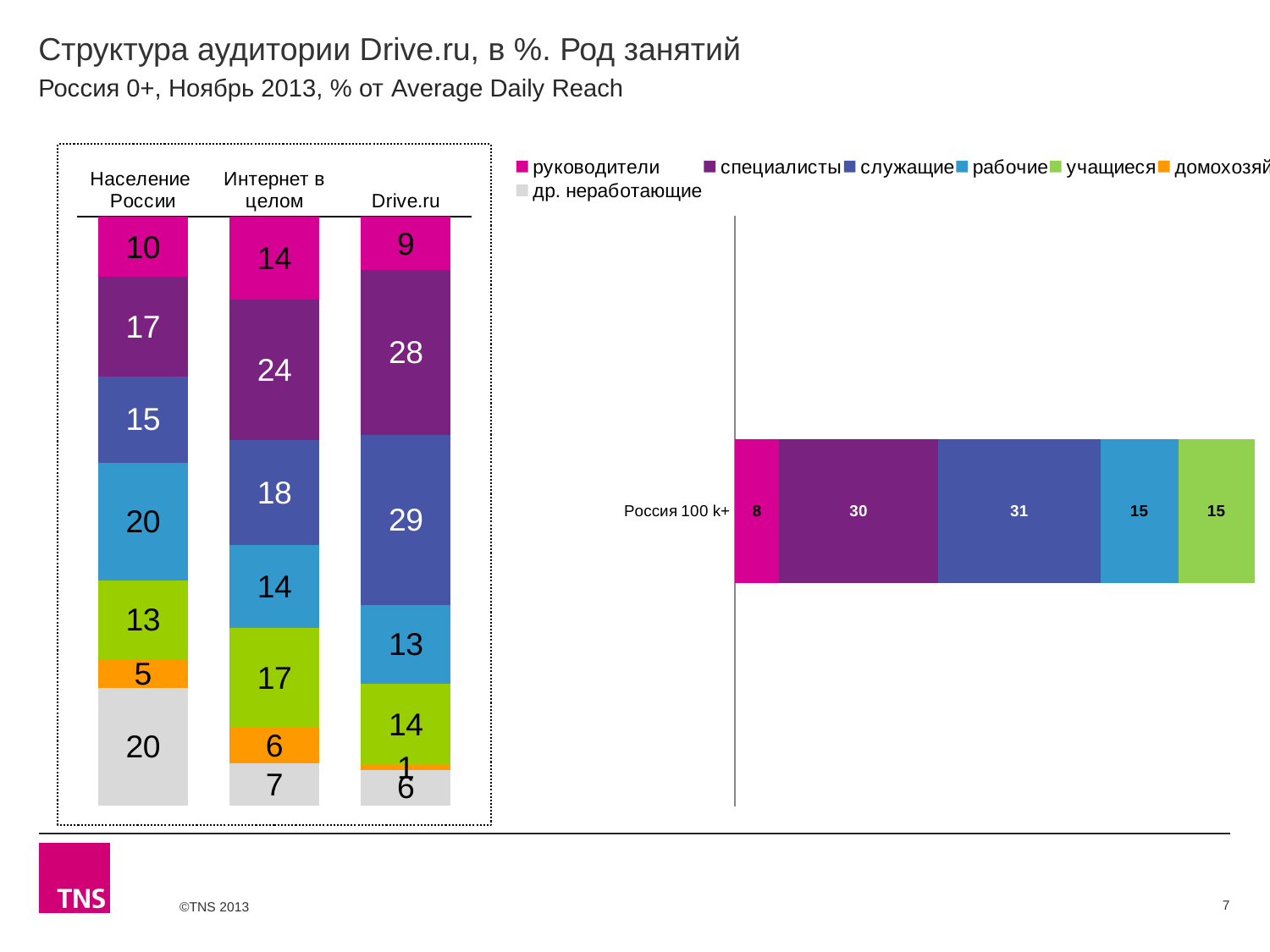
How many series does the legend list? 7 In the left stacked bar chart, which segment is the smallest in the Drive.ru bar? домохозяйки (1) How many bars does the left stacked bar chart contain? 3 In the left stacked bar chart, what is the value for др. неработающие in the Население России bar? 20 In the right chart (Россия 100 k+), what is the value for руководители? 8 In the left stacked bar chart, which of the three bars has the largest value for специалисты? Drive.ru In the right chart (Россия 100 k+), what is the value for служащие? 31 In the left stacked bar chart, is the рабочие value larger for Население России or for Drive.ru? Население России In the left stacked bar chart, what is the value for служащие in the Интернет в целом bar? 18 What type of chart is shown on the right side of the slide? Stacked bar chart In the left stacked bar chart, what is the value for специалисты in the Drive.ru bar? 28 In the left stacked bar chart, what is the difference between the служащие values for Drive.ru and Население России? 14